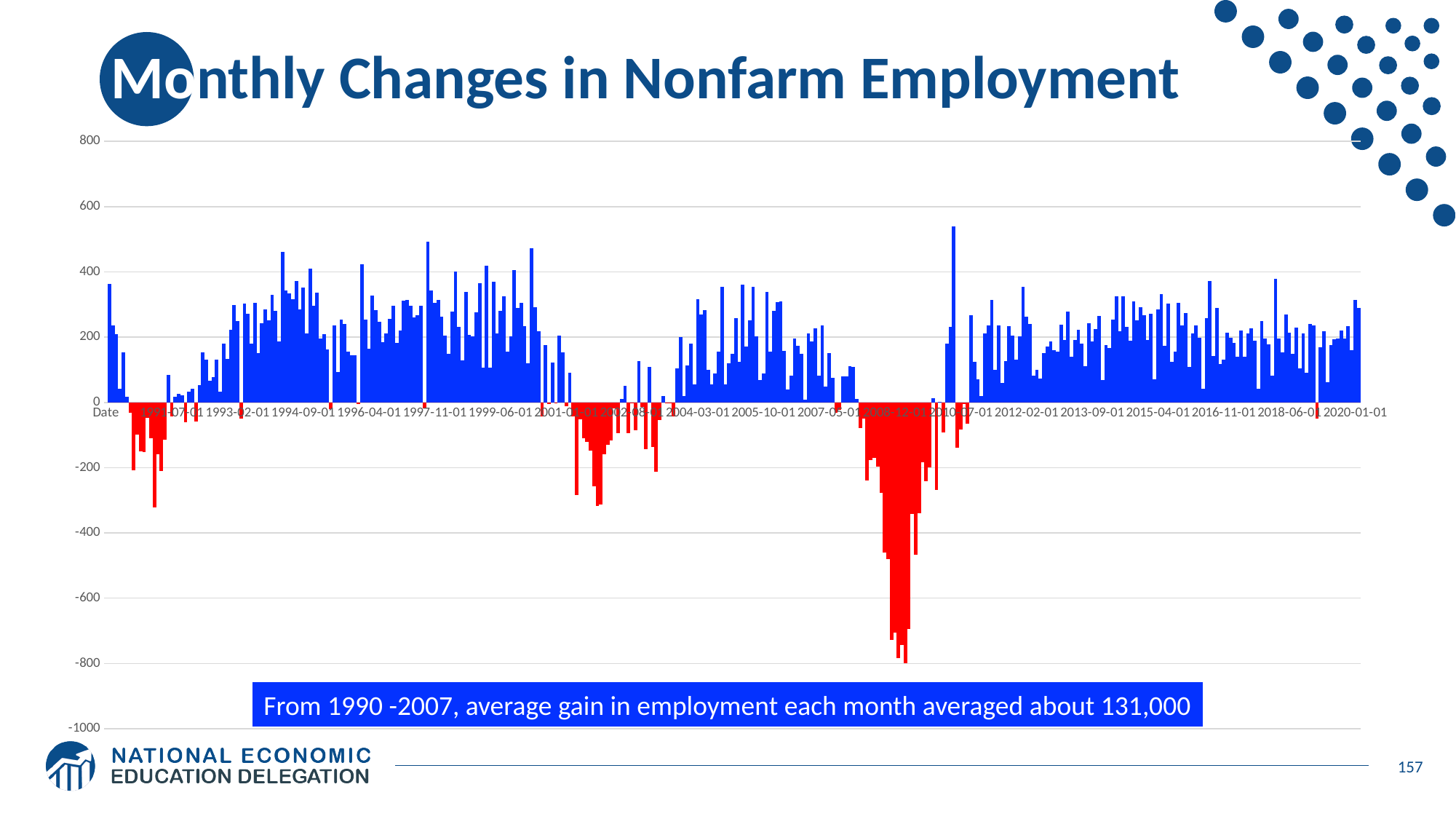
Is the deepest negative bar in the 1991 period greater or less than -400? greater Is the largest negative monthly change (around 2008-2009) greater or less than -600? less Is the tallest positive bar (around 2010) greater or less than 400? greater Which period shows the largest job losses: around 1991, around 2001-2002, or around 2008-2009? Around 2008-2009 What is the last date label shown on the horizontal axis? 2020-01-01 What colour are the bars representing negative monthly changes? Red What is the first date label shown on the horizontal axis after 'Date'? 1991-07-01 What is the title of the chart? Monthly Changes in Nonfarm Employment What is the lowest value shown on the vertical axis? -1000 What kind of chart is shown on the slide? Bar chart What is the highest value shown on the vertical axis? 800